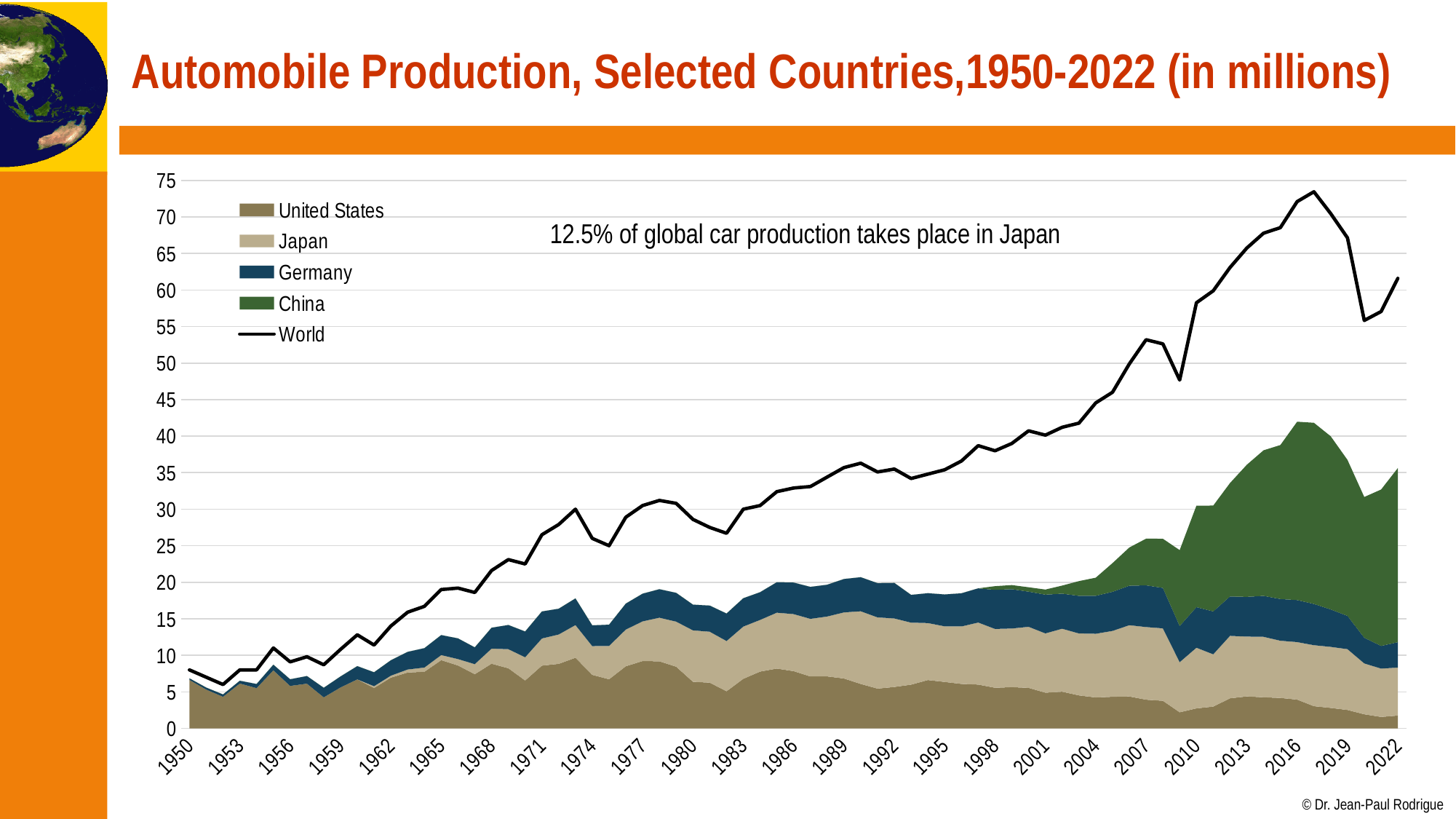
Is the value of the World line in 2013 greater or less than 60? greater Is the value of the World line in 1950 greater or less than 10? less How many series does the legend list? 5 Is the value of the World line in 2007 greater or less than 50? greater Which series is drawn as a black line rather than a filled area? World Overall, does the World line rise or fall from 1950 to 2022? rise According to the annotation on the chart, what share of global car production takes place in Japan? 12.5% How many year labels are shown on the x axis? 25 What kind of chart is shown on the slide? Stacked area chart with a line series